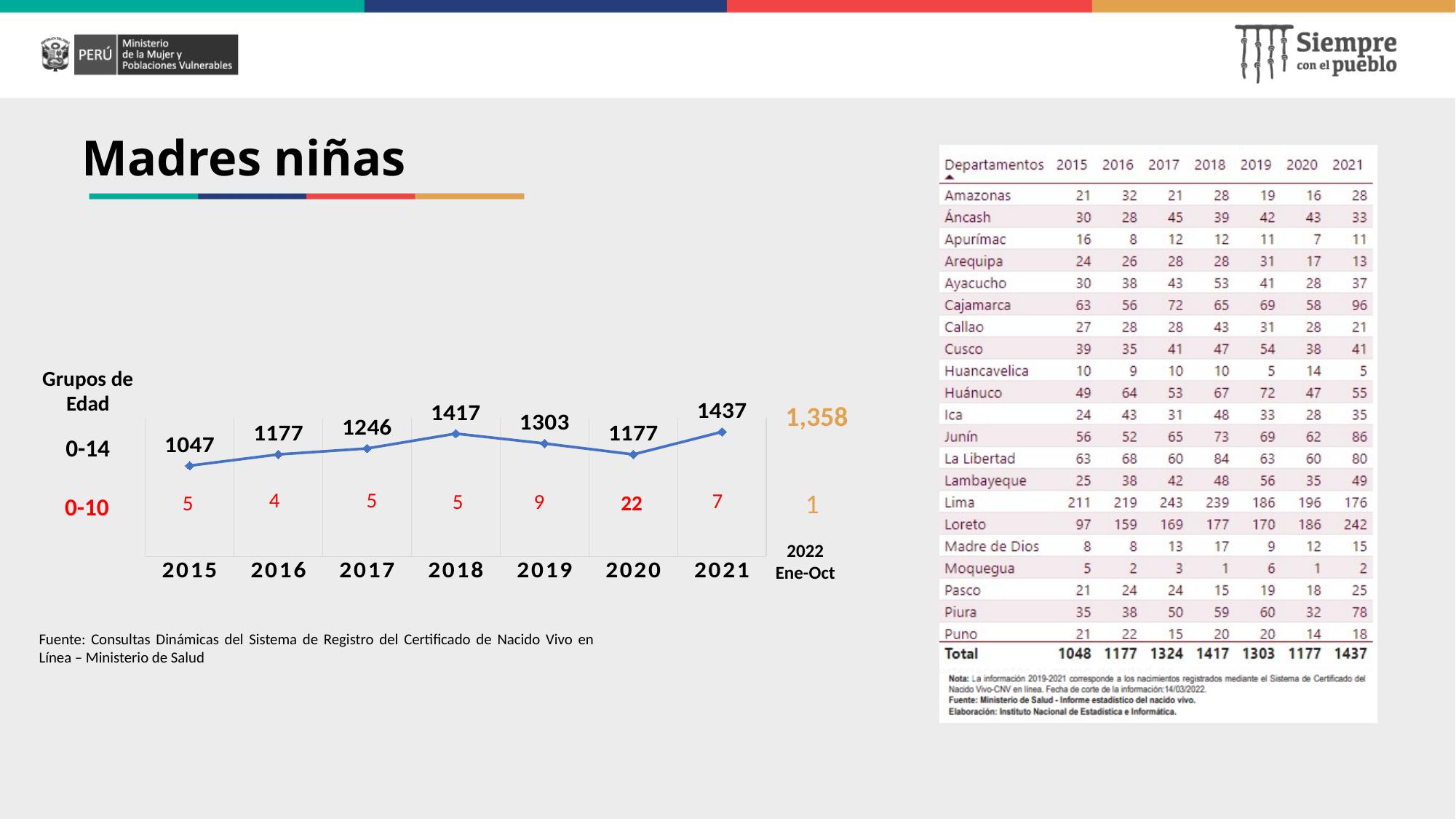
What is the difference between the 0-14 values for 2021 and 2020 in the line chart? 260 Which is larger in the line chart: the 0-14 value for 2017 or for 2019? 2019 In the line chart, what is the value for the 0-14 age group in 2020? 1177 Which year has the highest value for the 0-14 age group in the line chart? 2021 What value is shown for the 0-14 age group for 2022 Ene-Oct next to the line chart? 1,358 How many years are plotted on the x axis of the line chart? 7 What is the value shown in red for the 0-10 age group in 2020? 22 Which year has the lowest value for the 0-14 age group in the line chart? 2015 In the line chart, what is the value for the 0-14 age group in 2018? 1417 What type of chart is shown on the slide under the title 'Madres niñas'? line chart Does the 0-14 line rise or fall from 2015 to 2018 in the line chart? rise In the line chart, what is the value for the 0-14 age group in 2015? 1047